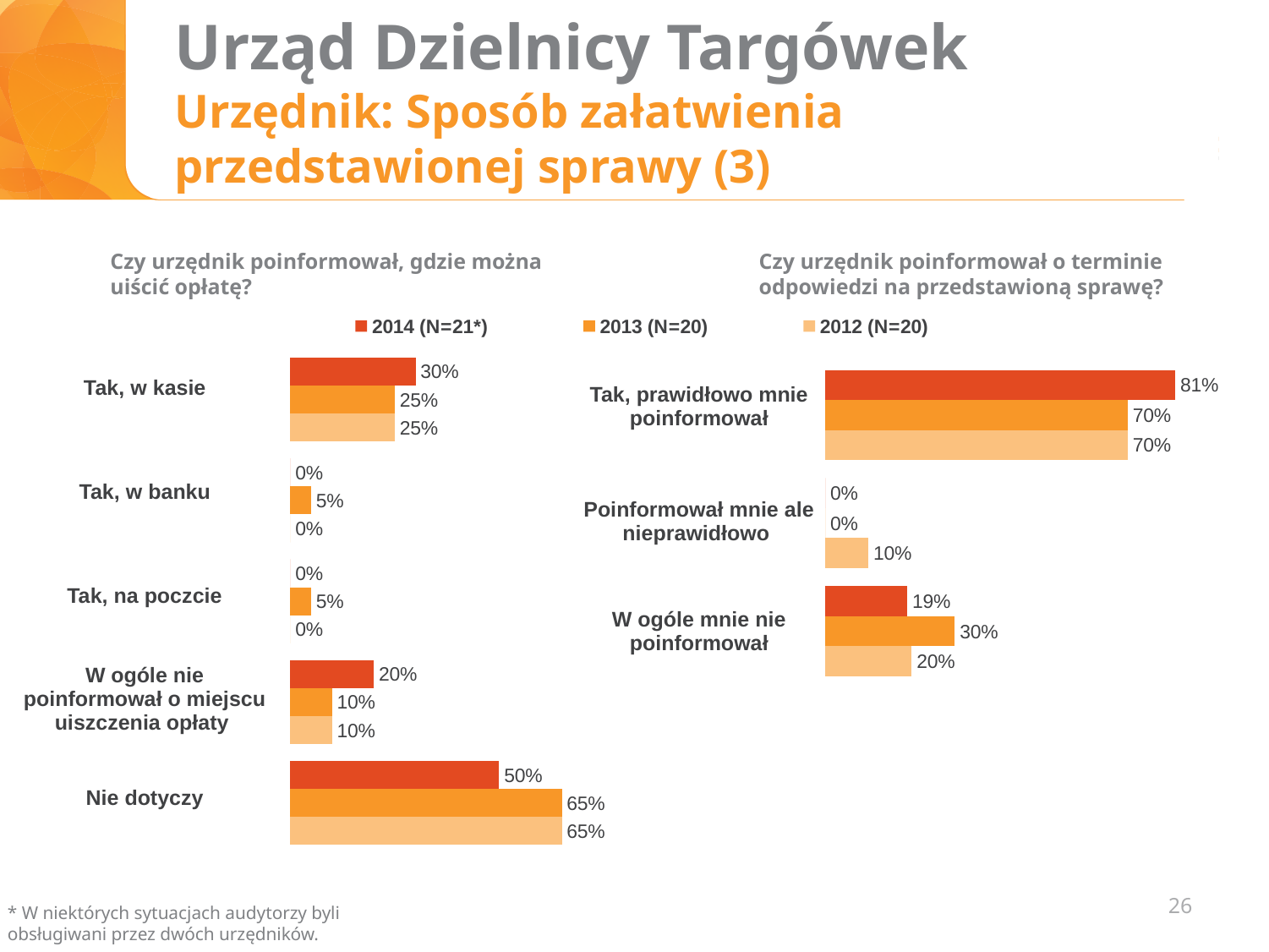
In the left chart ("Czy urzędnik poinformował, gdzie można uiścić opłatę?"), which category has the highest value for 2014 (N=21*)? Nie dotyczy In the right chart ("Czy urzędnik poinformował o terminie odpowiedzi na przedstawioną sprawę?"), what is the value for "W ogóle mnie nie poinformował" in 2013 (N=20)? 30% In the right chart ("Czy urzędnik poinformował o terminie odpowiedzi na przedstawioną sprawę?"), which is larger for "W ogóle mnie nie poinformował": the 2014 value or the 2012 value? 2012 In the left chart ("Czy urzędnik poinformował, gdzie można uiścić opłatę?"), what is the value for "Tak, w banku" in 2013 (N=20)? 5% In the left chart ("Czy urzędnik poinformował, gdzie można uiścić opłatę?"), what is the difference between the 2013 and 2014 values for "Nie dotyczy"? 15% How many series does the legend list for the charts on the slide? 3 In the left chart ("Czy urzędnik poinformował, gdzie można uiścić opłatę?"), what is the value for "Nie dotyczy" in 2013 (N=20)? 65% In the right chart ("Czy urzędnik poinformował o terminie odpowiedzi na przedstawioną sprawę?"), what is the difference between the 2014 and 2013 values for "Tak, prawidłowo mnie poinformował"? 11% What type of chart is the right chart ("Czy urzędnik poinformował o terminie odpowiedzi na przedstawioną sprawę?")? Bar chart In the left chart ("Czy urzędnik poinformował, gdzie można uiścić opłatę?"), how many categories are shown? 5 In the right chart ("Czy urzędnik poinformował o terminie odpowiedzi na przedstawioną sprawę?"), what is the value for "Tak, prawidłowo mnie poinformował" in 2014 (N=21*)? 81% In the left chart ("Czy urzędnik poinformował, gdzie można uiścić opłatę?"), what is the value for "Tak, w kasie" in 2014 (N=21*)? 30%